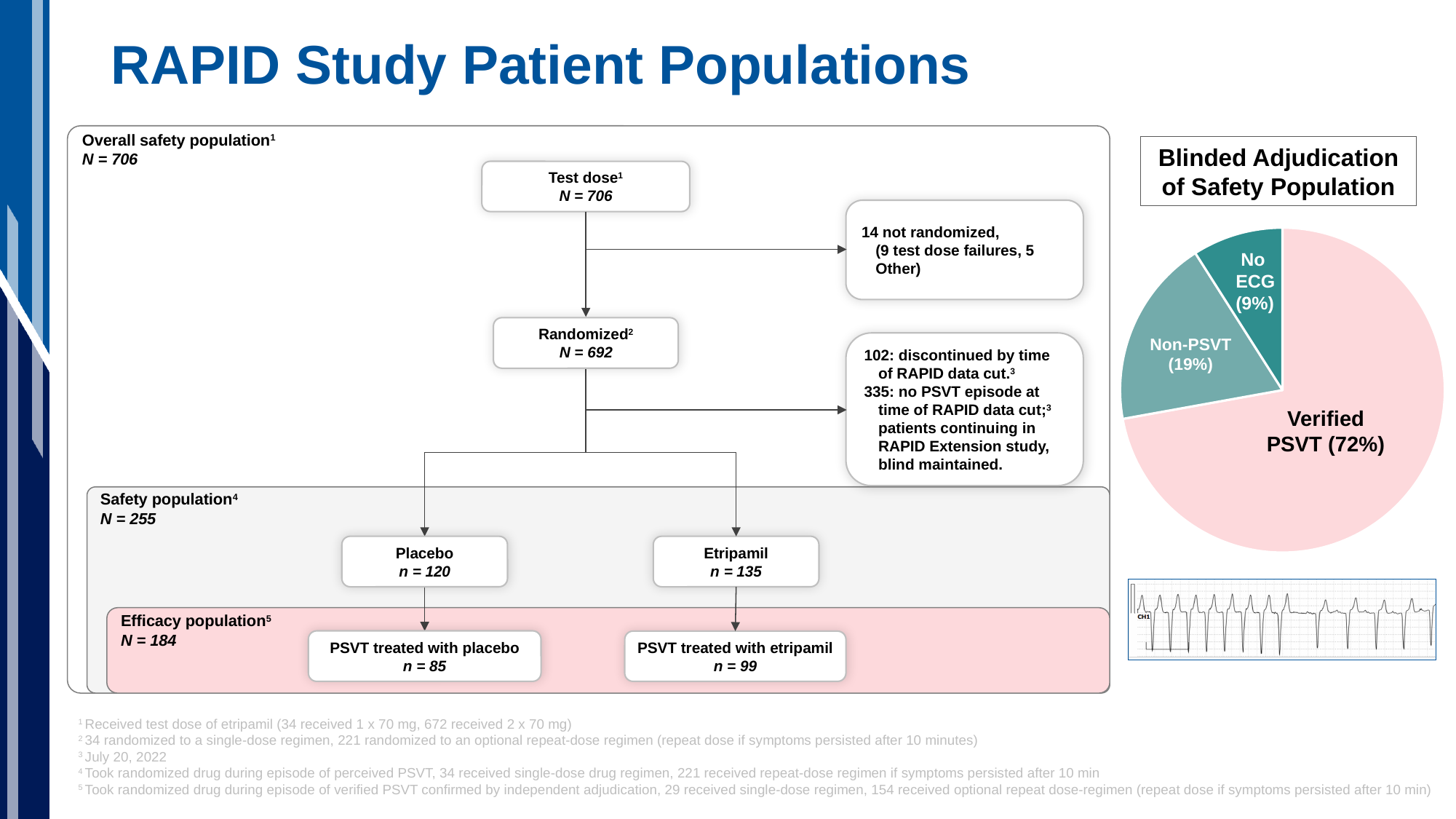
How many slices does the "Blinded Adjudication of Safety Population" pie chart have? 3 In the "Blinded Adjudication of Safety Population" pie chart, what percentage is shown for Non-PSVT? 19% In the "Blinded Adjudication of Safety Population" pie chart, what colour is the Verified PSVT slice? Light pink In the "Blinded Adjudication of Safety Population" pie chart, which is larger: Non-PSVT or No ECG? Non-PSVT In the "Blinded Adjudication of Safety Population" pie chart, how many percentage points larger is Verified PSVT than Non-PSVT? 53 percentage points In the "Blinded Adjudication of Safety Population" pie chart, what share is labelled for Verified PSVT? 72% In the "Blinded Adjudication of Safety Population" pie chart, what percentage is shown for No ECG? 9% What kind of chart is shown under the heading "Blinded Adjudication of Safety Population"? Pie chart Which slice of the "Blinded Adjudication of Safety Population" pie chart is the smallest? No ECG Which slice of the "Blinded Adjudication of Safety Population" pie chart is the largest? Verified PSVT What is the title shown above the pie chart on the right of the slide? Blinded Adjudication of Safety Population In the "Blinded Adjudication of Safety Population" pie chart, what is the difference in percentage points between Non-PSVT and No ECG? 10 percentage points